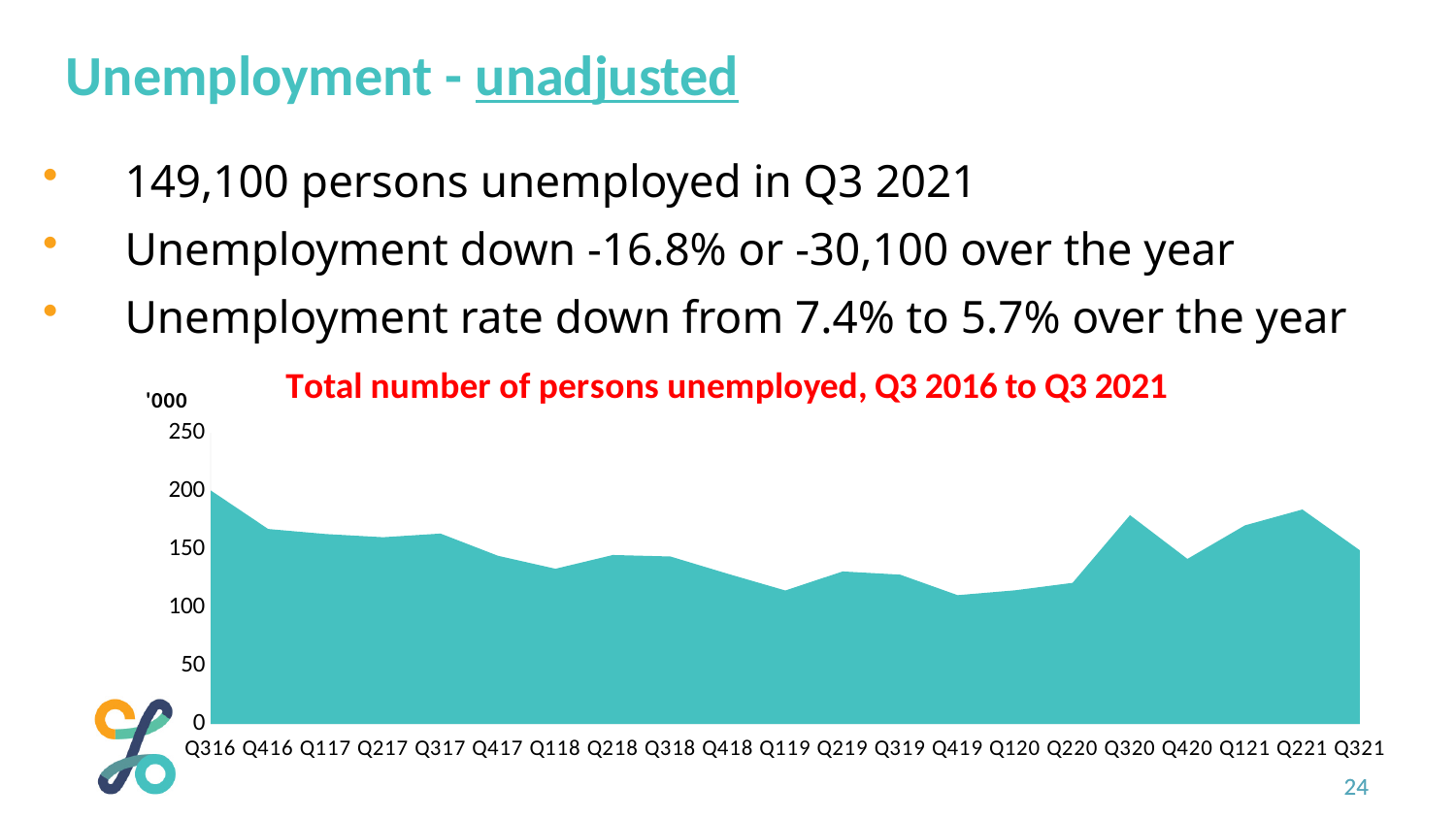
Is the value for Q420 greater or less than 150? less Is the value for Q316 greater or less than 150? greater Is the value for Q419 greater or less than 100? greater Do the values generally rise or fall from Q316 to Q419? fall What is the title of the chart? Total number of persons unemployed, Q3 2016 to Q3 2021 What kind of chart is shown on the slide? area chart How many quarters are plotted along the x axis of the chart? 21 What unit label is shown at the top of the y axis? '000 Which is larger, the value for Q316 or the value for Q419? Q316